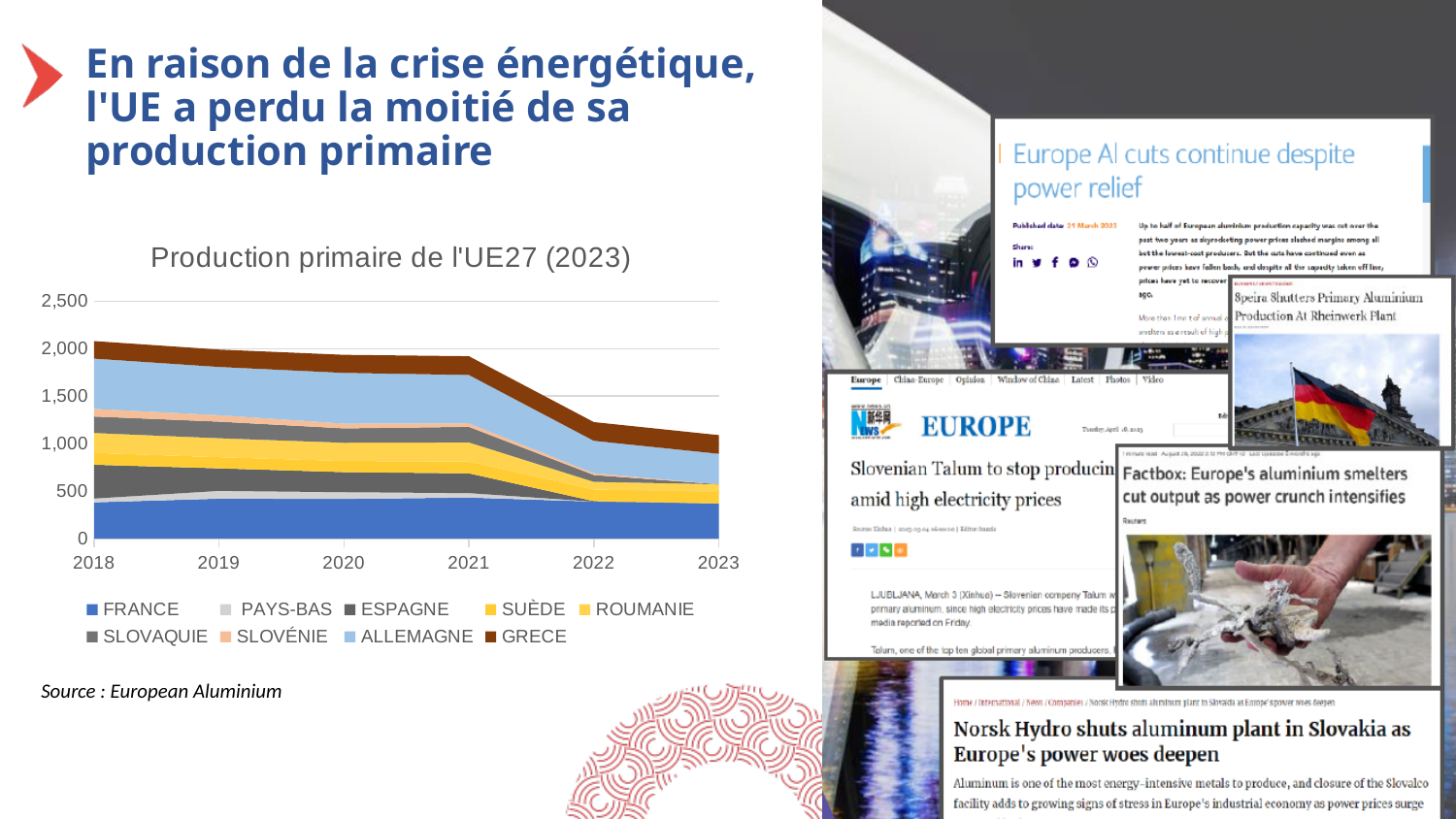
Does the total primary production rise or fall from 2018 to 2023? Fall Which country contributes the largest share of production in 2018? ALLEMAGNE How many series does the chart legend list? 9 How many years are shown along the x axis of the chart? 6 What kind of chart is shown on the slide? Stacked area chart Is the total stacked value for 2023 greater or less than 1,500? less Which year has the lowest total primary production? 2023 Which is larger, the total primary production in 2018 or in 2023? 2018 What is the title of the chart? Production primaire de l'UE27 (2023) Is the total stacked value for 2022 greater or less than 1,500? less Is the total stacked value for 2018 greater or less than 1,500? greater